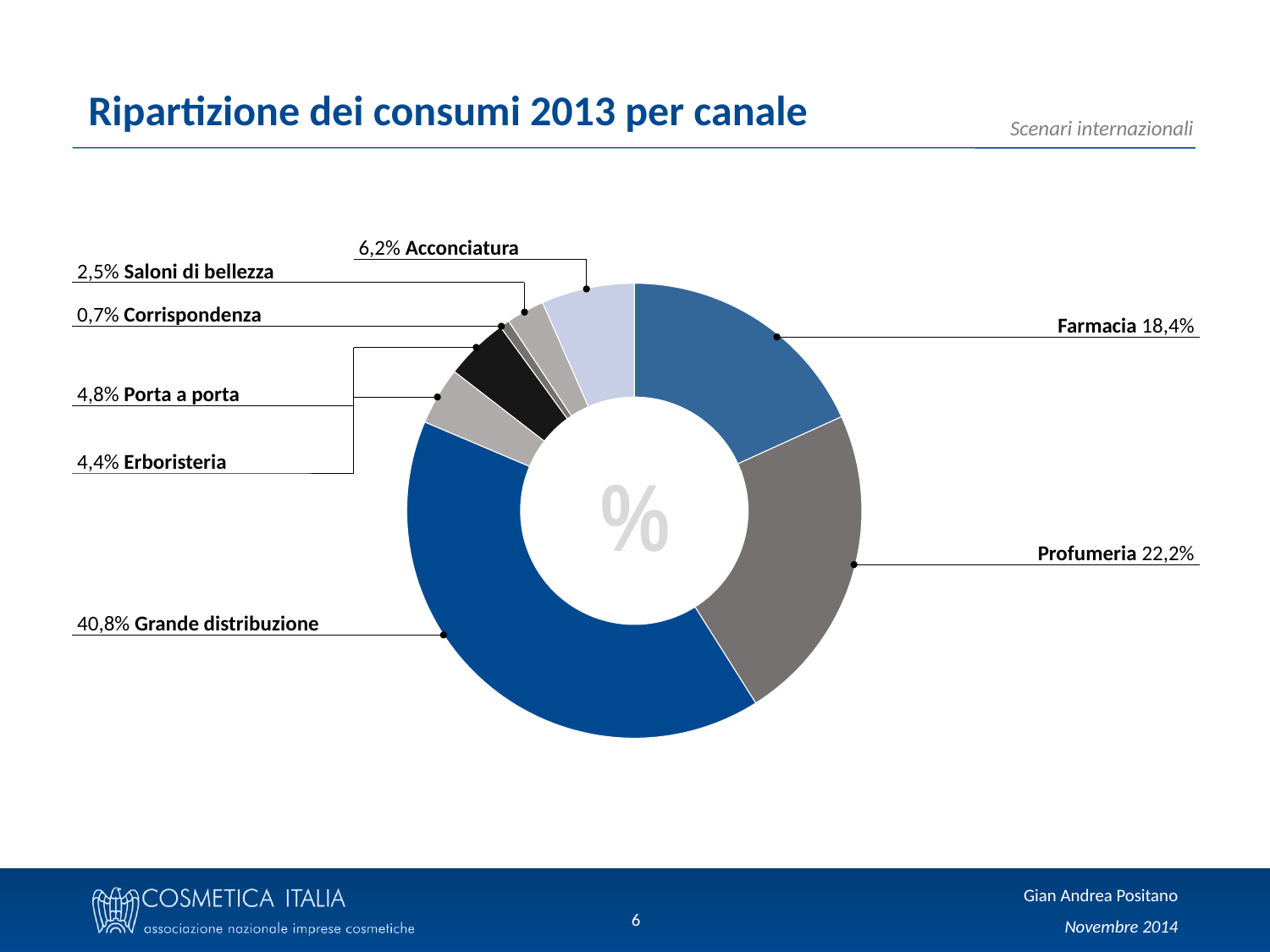
What kind of chart is shown on the slide? Pie chart (donut) What percentage is shown for Profumeria? 22,2% Which has a larger share, Acconciatura or Saloni di bellezza? Acconciatura Which has a larger share, Porta a porta or Erboristeria? Porta a porta What is the value shown for Farmacia? 18,4% Which channel has the smallest share of consumption? Corrispondenza What is the value for Corrispondenza? 0,7% What share of 2013 consumption does Grande distribuzione account for? 40,8% What is the difference in percentage points between Profumeria and Farmacia? 3,8 What is the title of the slide? Ripartizione dei consumi 2013 per canale How many channels are shown in the chart? 8 Which channel has the largest share of consumption? Grande distribuzione